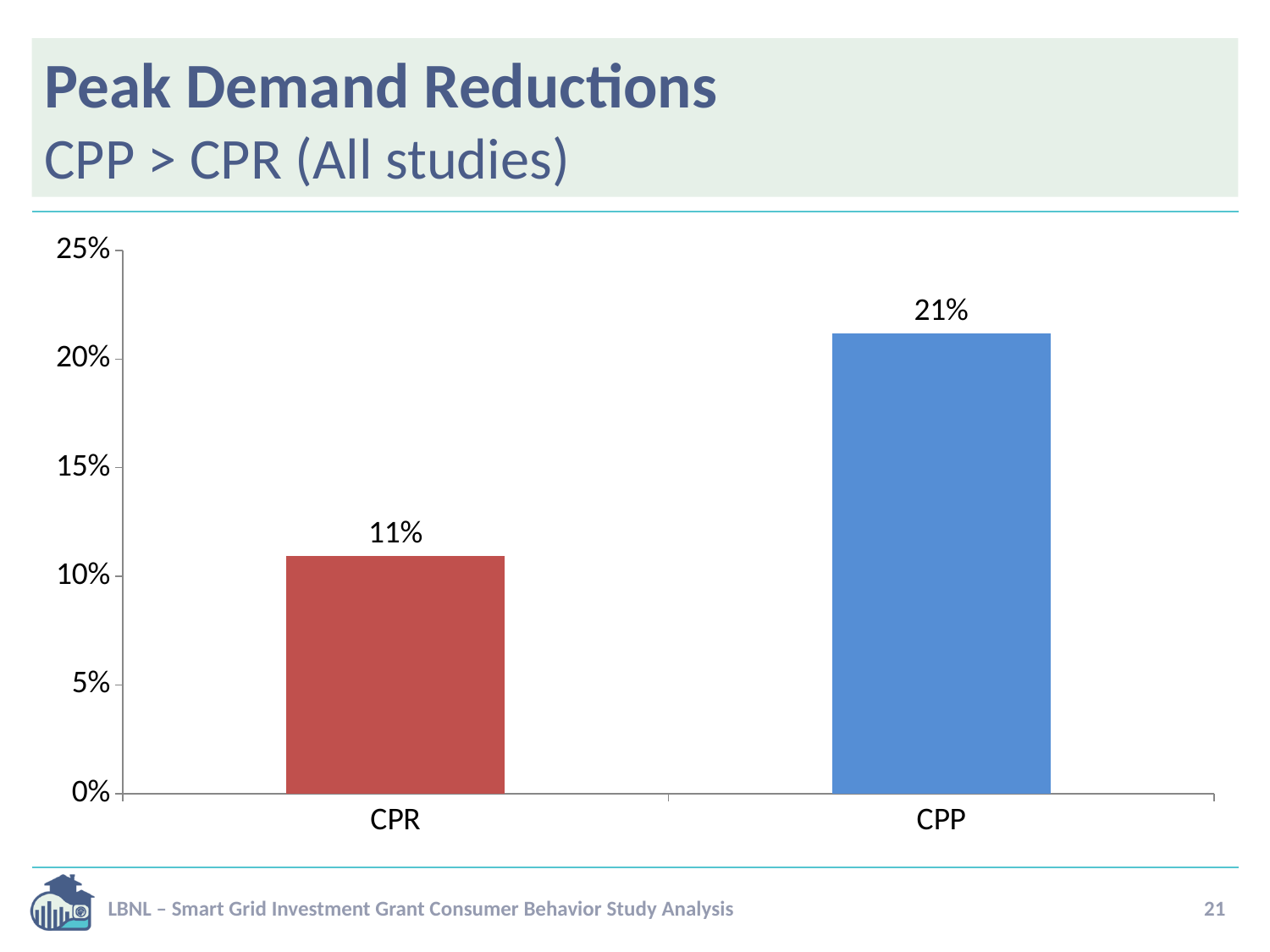
What is the peak demand reduction value for CPP? 21% What kind of chart is shown on the slide? bar chart What is the maximum value shown on the y axis? 25% What is the peak demand reduction value for CPR? 11% Is the value for CPR greater or less than 15%? less How many categories are shown on the x axis? 2 Is the value for CPP greater or less than 20%? greater What is the difference between the CPP and CPR values? 10% Which category has the highest peak demand reduction? CPP Which is larger, the value for CPR or the value for CPP? CPP Which category has the lowest peak demand reduction? CPR What colour is the bar for CPP? blue